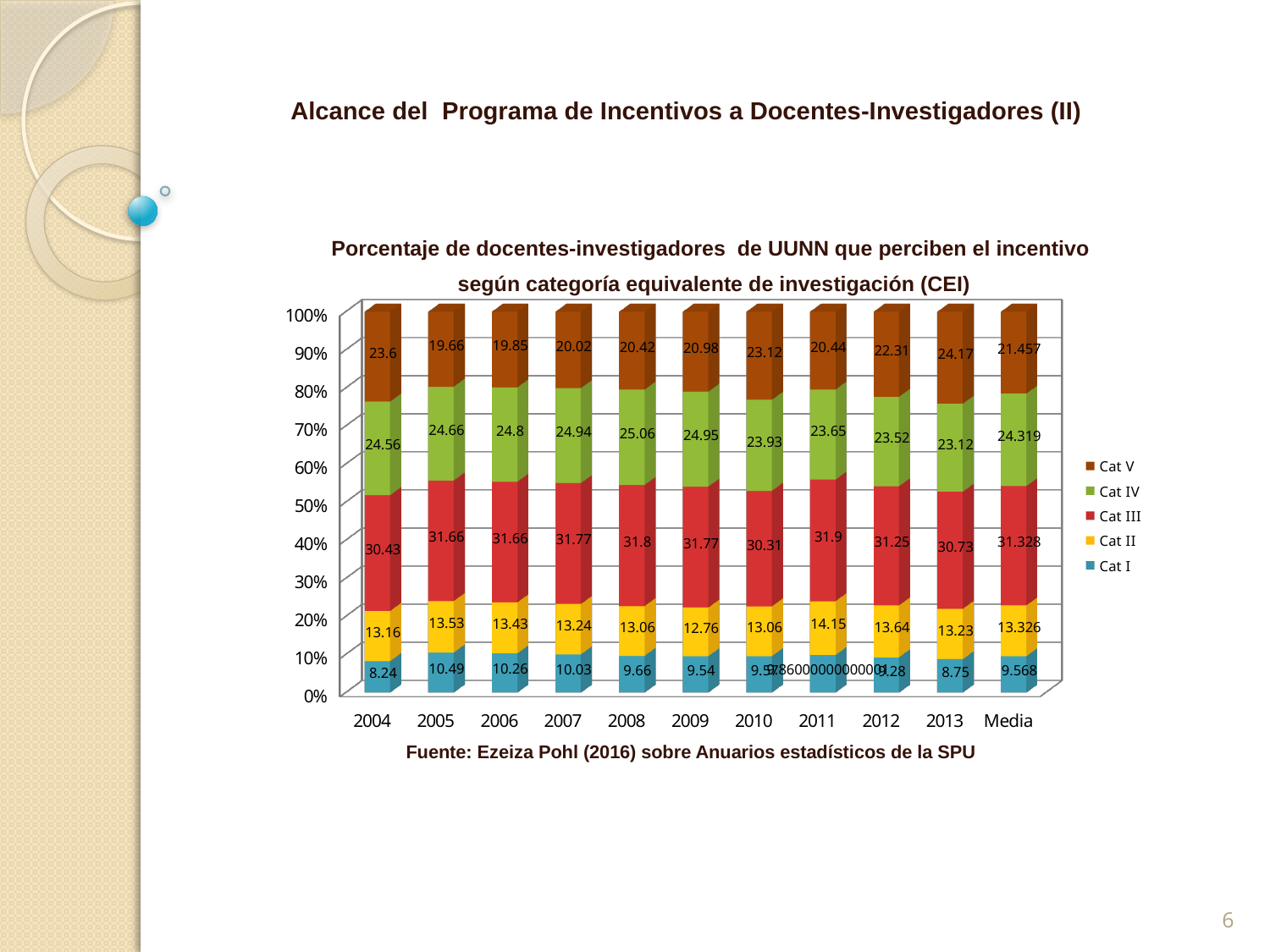
How many series does the legend list? 5 How many categories are shown on the x axis? 11 Does the Cat I value rise or fall from 2005 to 2009? Fall Which is larger, the Cat III value for 2005 or for 2013? 2005 What is the difference between the Cat I values for 2005 and 2004? 2.25 What is the Cat IV value for Media? 24.319 What is the Cat I value for 2013? 8.75 What kind of chart is shown? Stacked bar chart What is the Cat III value for 2011? 31.9 Which year has the highest Cat I value? 2005 Which year has the lowest Cat V value? 2005 What is the Cat V value for 2004? 23.6